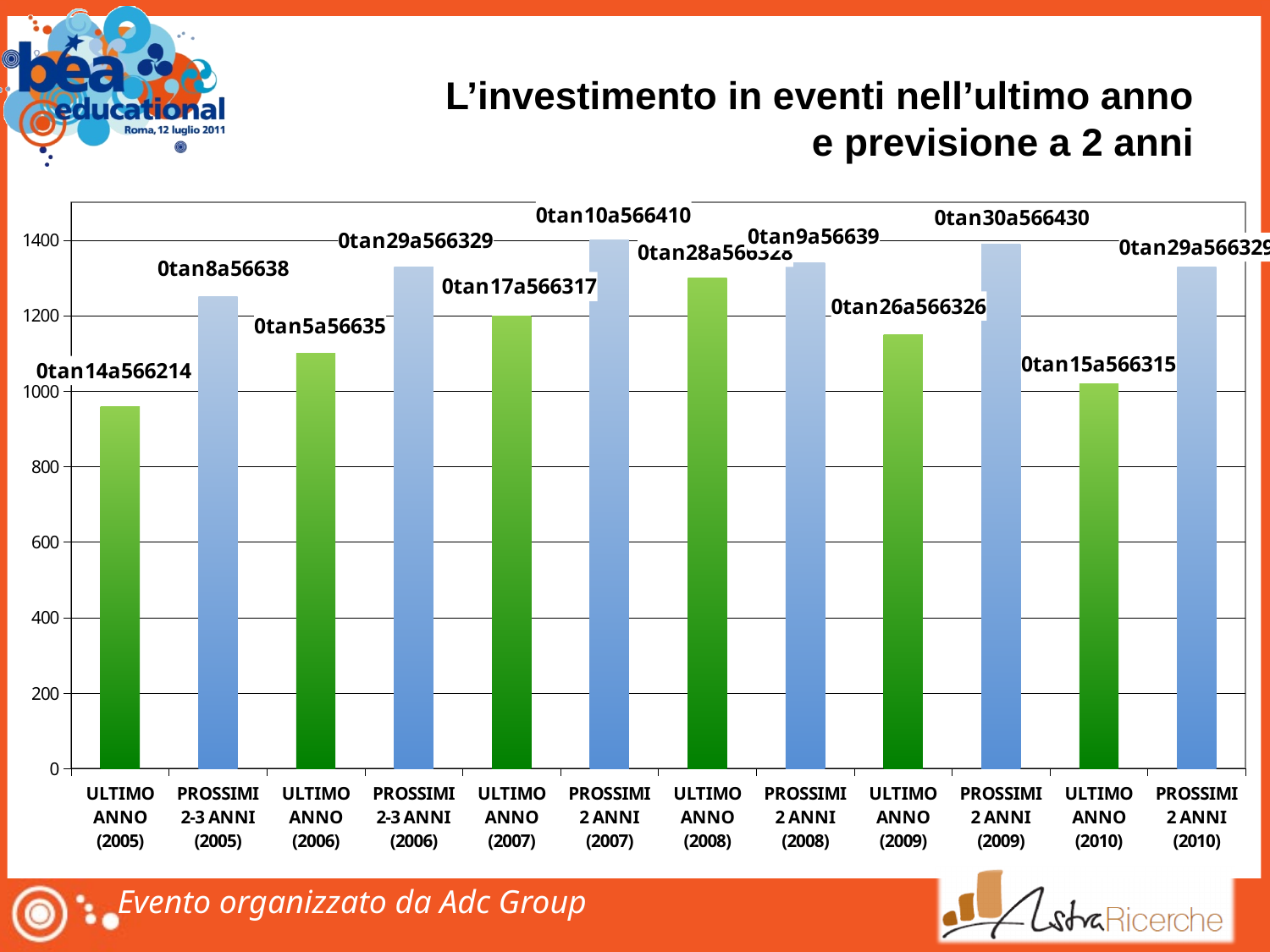
Is the value for PROSSIMI 2-3 ANNI (2005) greater or less than 1200? greater What colour are the bars for the ULTIMO ANNO categories? Green What kind of chart is shown on the slide? Bar chart Is the value for ULTIMO ANNO (2010) greater or less than 1000? greater Which is larger, the value for ULTIMO ANNO (2008) or ULTIMO ANNO (2009)? ULTIMO ANNO (2008) Is the value for ULTIMO ANNO (2009) greater or less than 1200? less Which is larger, the value for PROSSIMI 2-3 ANNI (2005) or PROSSIMI 2 ANNI (2007)? PROSSIMI 2 ANNI (2007) What is the title of the chart on the slide? L'investimento in eventi nell'ultimo anno e previsione a 2 anni How many bars are plotted in the chart? 12 Which category has the lowest bar in the chart? ULTIMO ANNO (2005)